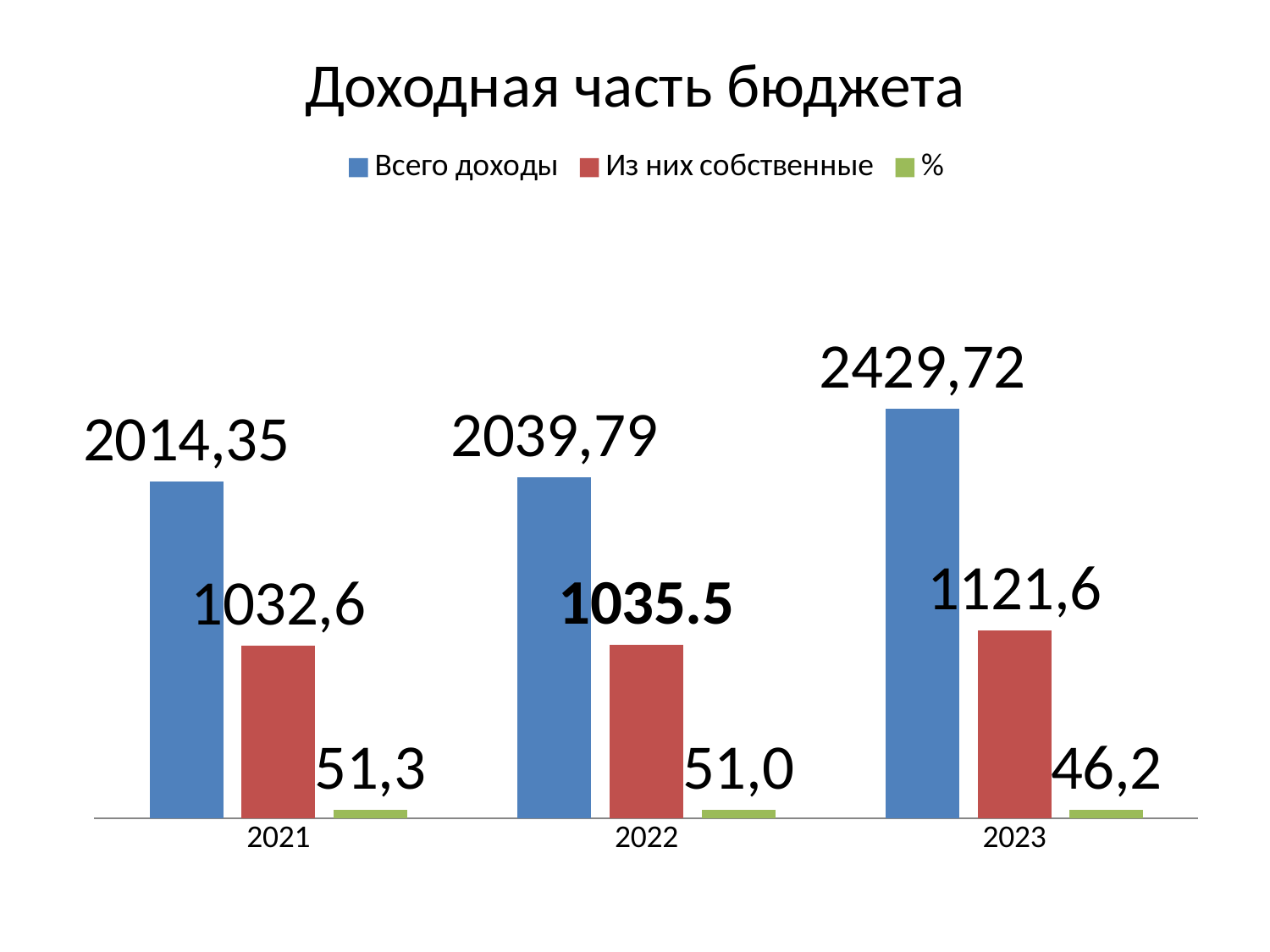
What is the difference between Всего доходы in 2023 and in 2021? 415,37 How many years are shown on the x axis? 3 Does the % series rise or fall from 2021 to 2023? fall How many series does the legend list? 3 What is the value of Всего доходы for 2023? 2429,72 What is the value of Из них собственные for 2021? 1032,6 What is the value of Из них собственные for 2022? 1035.5 In which year is the % value the lowest? 2023 What is the difference between the % value in 2021 and in 2023? 5,1 What is the value of % for 2022? 51,0 Which is larger: Из них собственные in 2023 or in 2021? 2023 In which year is Всего доходы the highest? 2023